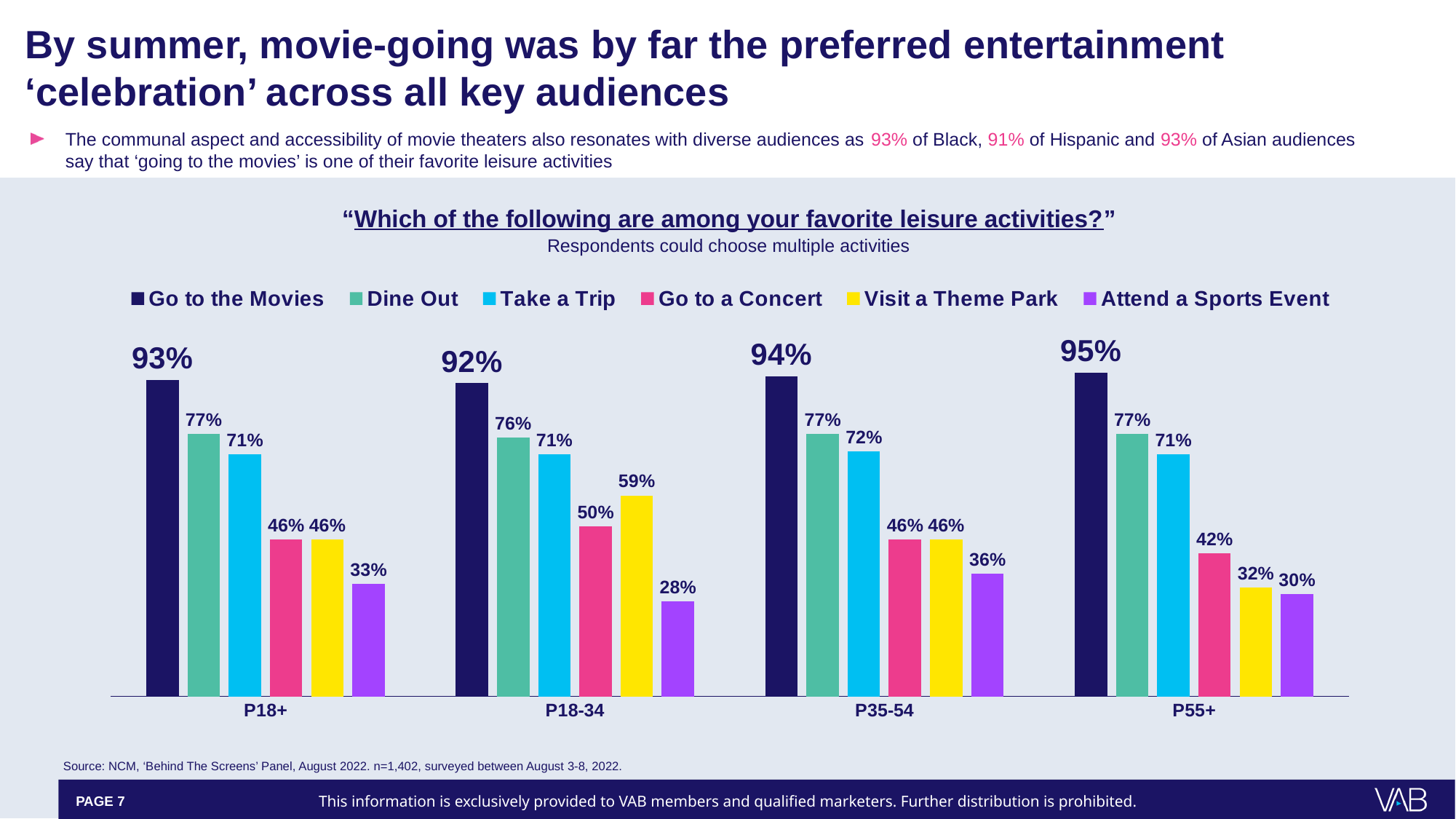
What percentage of P18-34 respondents chose Go to the Movies as a favorite leisure activity? 92% Which activity has the lowest value among P18-34? Attend a Sports Event Which series is shown in yellow in the legend? Visit a Theme Park How many age groups are shown on the x axis? 4 Which is larger for P55+: Go to a Concert or Visit a Theme Park? Go to a Concert What is the value for Visit a Theme Park among P18-34? 59% What is the value for Go to a Concert among P35-54? 46% How many series does the legend list? 6 What is the difference between Go to the Movies and Dine Out for P18+? 16% What is the value for Attend a Sports Event among P55+? 30% Which age group has the highest value for Go to the Movies? P55+ What kind of chart is shown on the slide? Bar chart